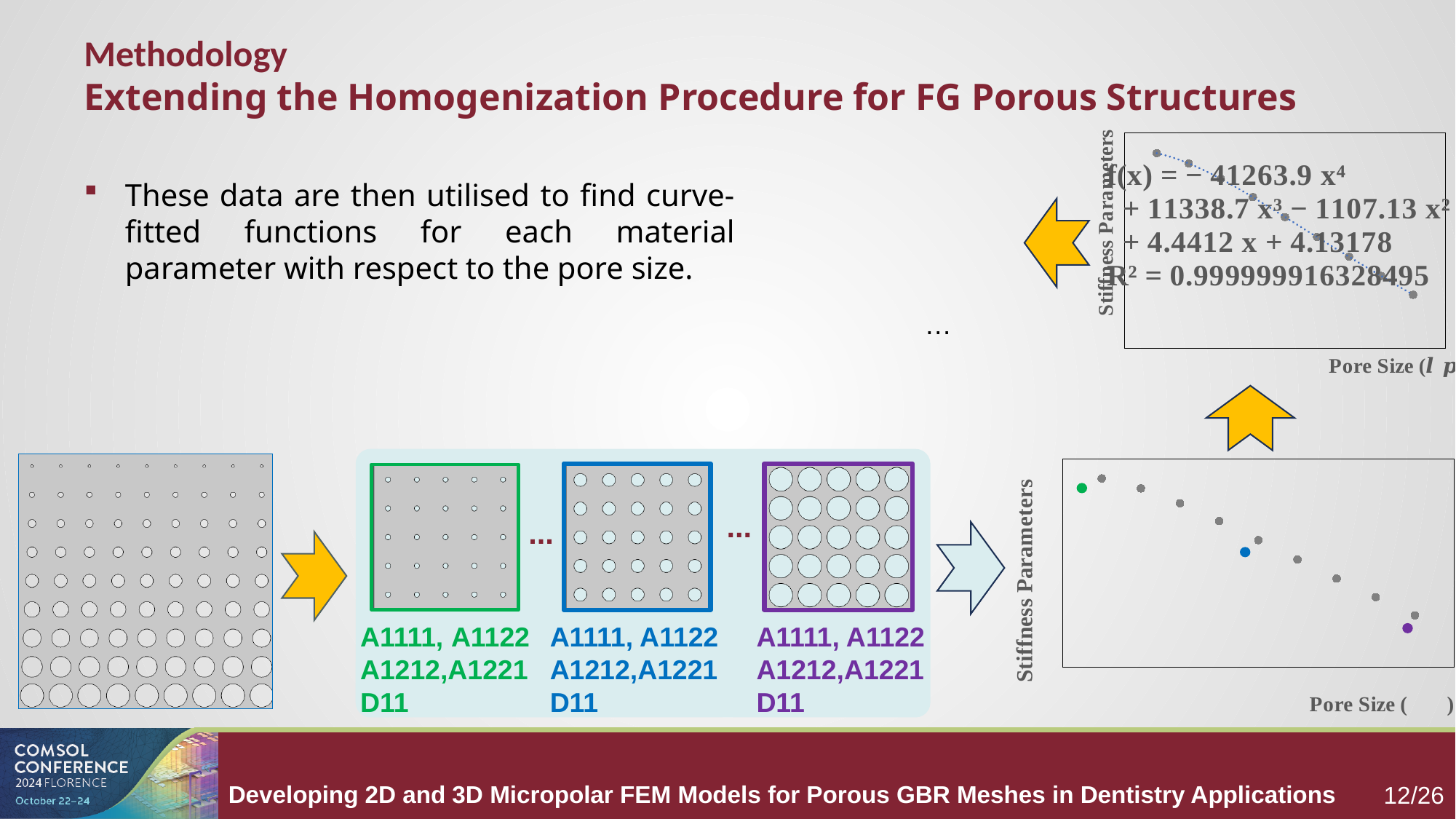
In the bottom-right chart, which coloured point has the lowest stiffness parameter value: the green, blue or purple one? purple In the top-right chart with the fitted curve, do the plotted values rise or fall from left to right? fall What is the y-axis title of the bottom-right chart? Stiffness Parameters In the bottom-right chart, do the stiffness parameter values rise or fall as pore size increases? fall In the bottom-right chart, is the value of the green point larger or smaller than the value of the blue point? larger What kind of chart is the bottom-right chart plotting Stiffness Parameters against Pore Size? scatter chart In the bottom-right chart, which coloured point has the highest stiffness parameter value: the green, blue or purple one? green What R² value is printed on the top-right chart with the fitted curve? R² = 0.999999916328495